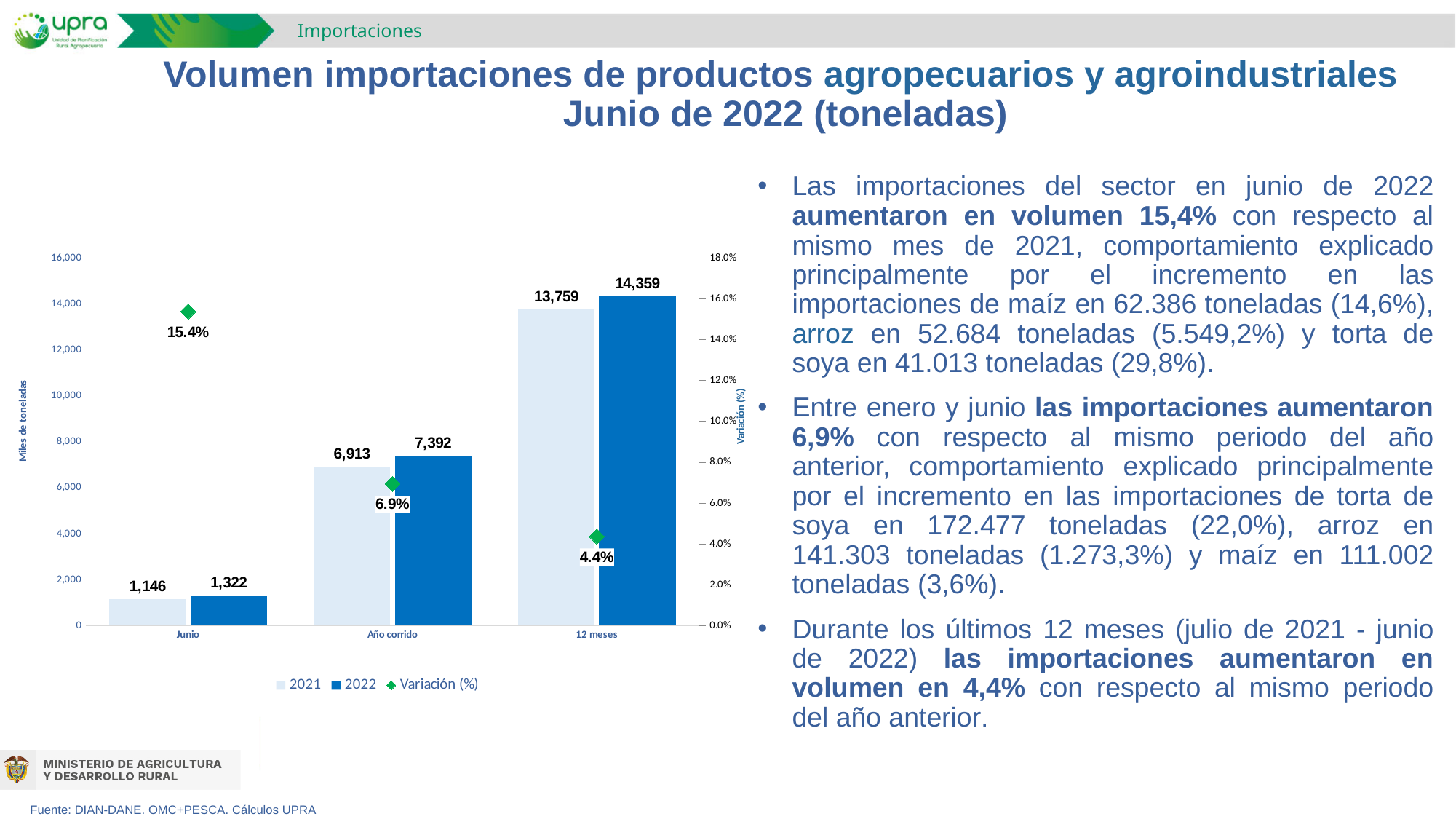
Which category has the lowest Variación (%)? 12 meses Is the 2021 value for 12 meses greater or less than 12,000? greater Which category has the highest 2022 value? 12 meses Which is larger for Año corrido, the 2021 value or the 2022 value? 2022 What is the 2021 value for Año corrido? 6,913 What is the difference between the 2022 and 2021 values for 12 meses? 600 What is the 2022 value for Junio? 1,322 How many series does the legend list? 3 What is the Variación (%) value for 12 meses? 4.4% What kind of chart is used for the 2021 and 2022 series? bar chart What is the label of the left vertical axis? Miles de toneladas How many categories are shown on the x axis? 3